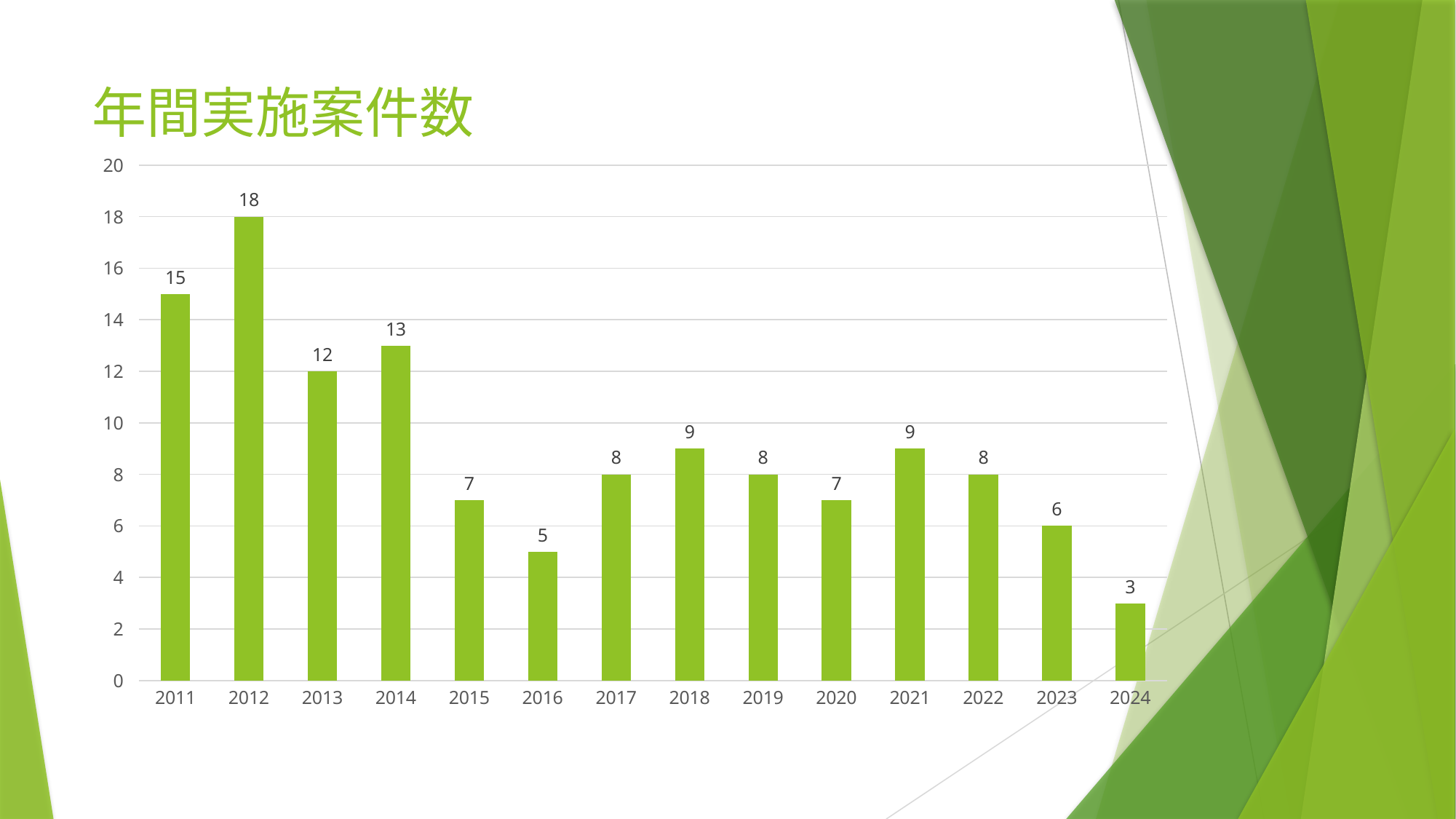
What is the value for 2016? 5 Which is larger, the value for 2014 or the value for 2018? 2014 What kind of chart is shown on the slide? bar chart What is the value for 2024? 3 What is the difference between the values for 2011 and 2013? 3 Is the value for 2021 greater or less than 10? less Which year has the highest value? 2012 How many years are shown on the x axis? 14 What is the title of the slide? 年間実施案件数 Which year has the lowest value? 2024 What is the value for 2012? 18 Do the values generally rise or fall from 2021 to 2024? fall